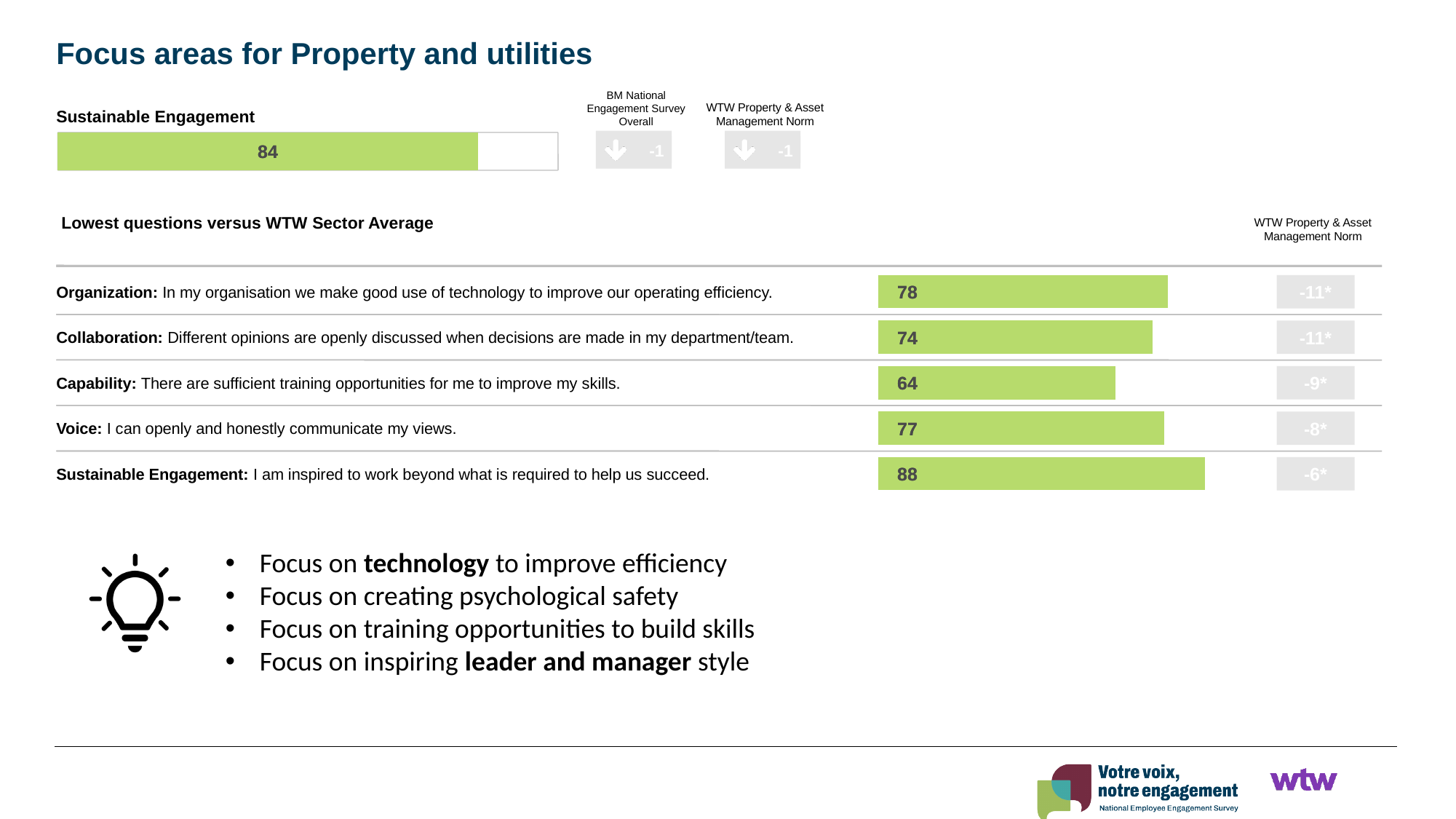
In the 'Sustainable Engagement' bar at the top of the slide, what score is shown? 84 In the 'Sustainable Engagement' bar at the top of the slide, what is the difference shown versus the BM National Engagement Survey Overall? -1 What kind of chart is used in the 'Lowest questions versus WTW Sector Average' section? Bar chart In the 'Lowest questions versus WTW Sector Average' chart, what is the value for the Capability question? 64 In the 'Lowest questions versus WTW Sector Average' chart, which has a higher score, Collaboration or Voice? Voice In the 'Lowest questions versus WTW Sector Average' chart, what is the difference between the Sustainable Engagement score and the Capability score? 24 In the 'Lowest questions versus WTW Sector Average' chart, what is the WTW Property & Asset Management Norm difference shown for the Capability question? -9* In the 'Lowest questions versus WTW Sector Average' chart, how many questions are listed? 5 In the 'Lowest questions versus WTW Sector Average' chart, which question has the highest score? Sustainable Engagement In the 'Lowest questions versus WTW Sector Average' chart, which question has the lowest score? Capability In the 'Lowest questions versus WTW Sector Average' chart, what is the value for the Voice question? 77 In the 'Lowest questions versus WTW Sector Average' chart, what is the value for the Organization question? 78